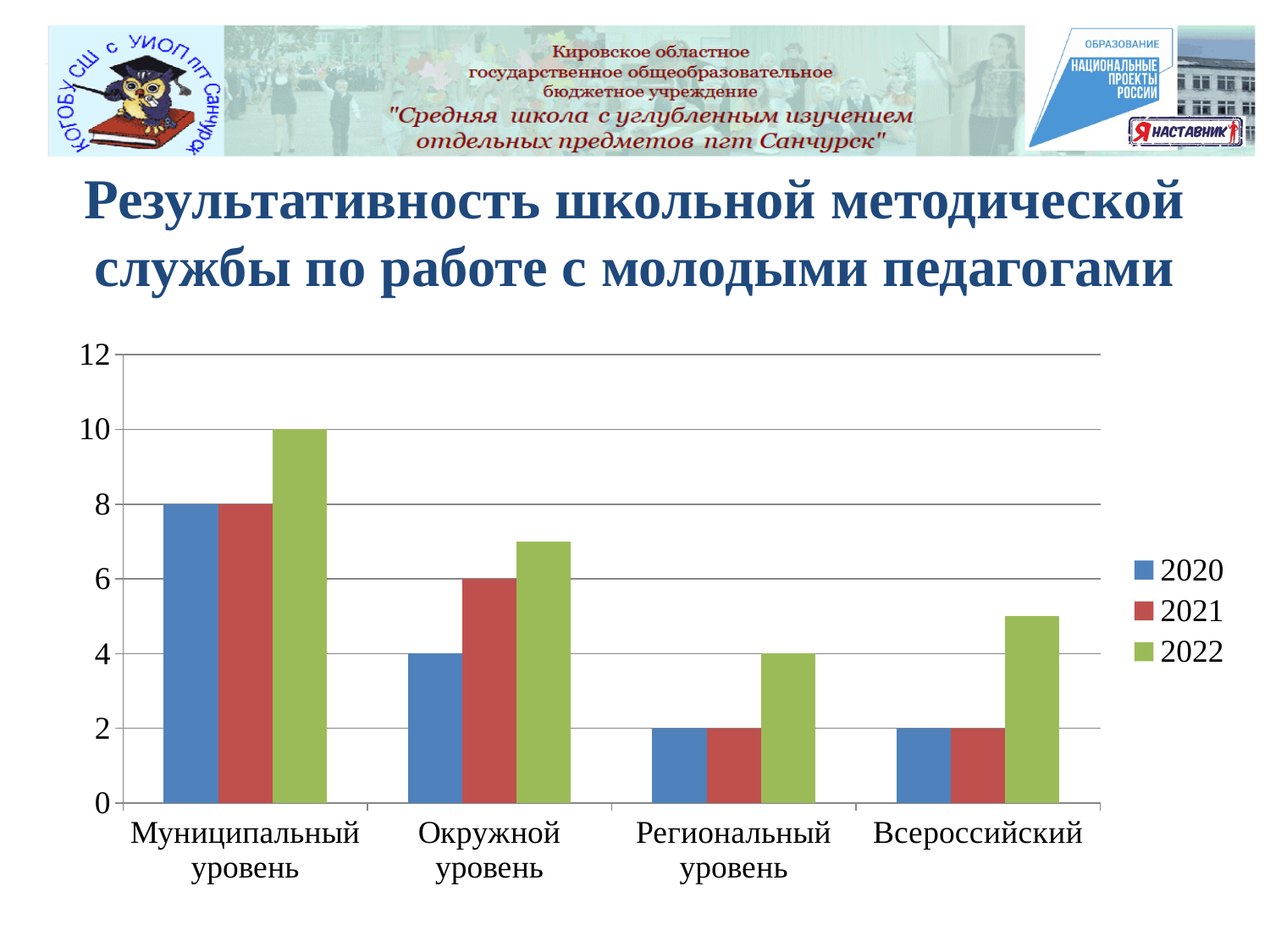
What is the difference between the 2022 and 2020 values at Муниципальный уровень? 2 What is the value for 2022 at Муниципальный уровень? 10 How many categories are shown on the x axis? 4 What is the value for 2020 at Муниципальный уровень? 8 Which category has the highest value for 2022? Муниципальный уровень Is the value for 2022 at Всероссийский greater or less than 4? greater What is the value for 2021 at Окружной уровень? 6 How many series does the legend list? 3 What is the value for 2020 at Окружной уровень? 4 Which is larger at Окружной уровень: the value for 2020 or the value for 2021? 2021 What kind of chart is shown on the slide? bar chart What is the value for 2022 at Региональный уровень? 4